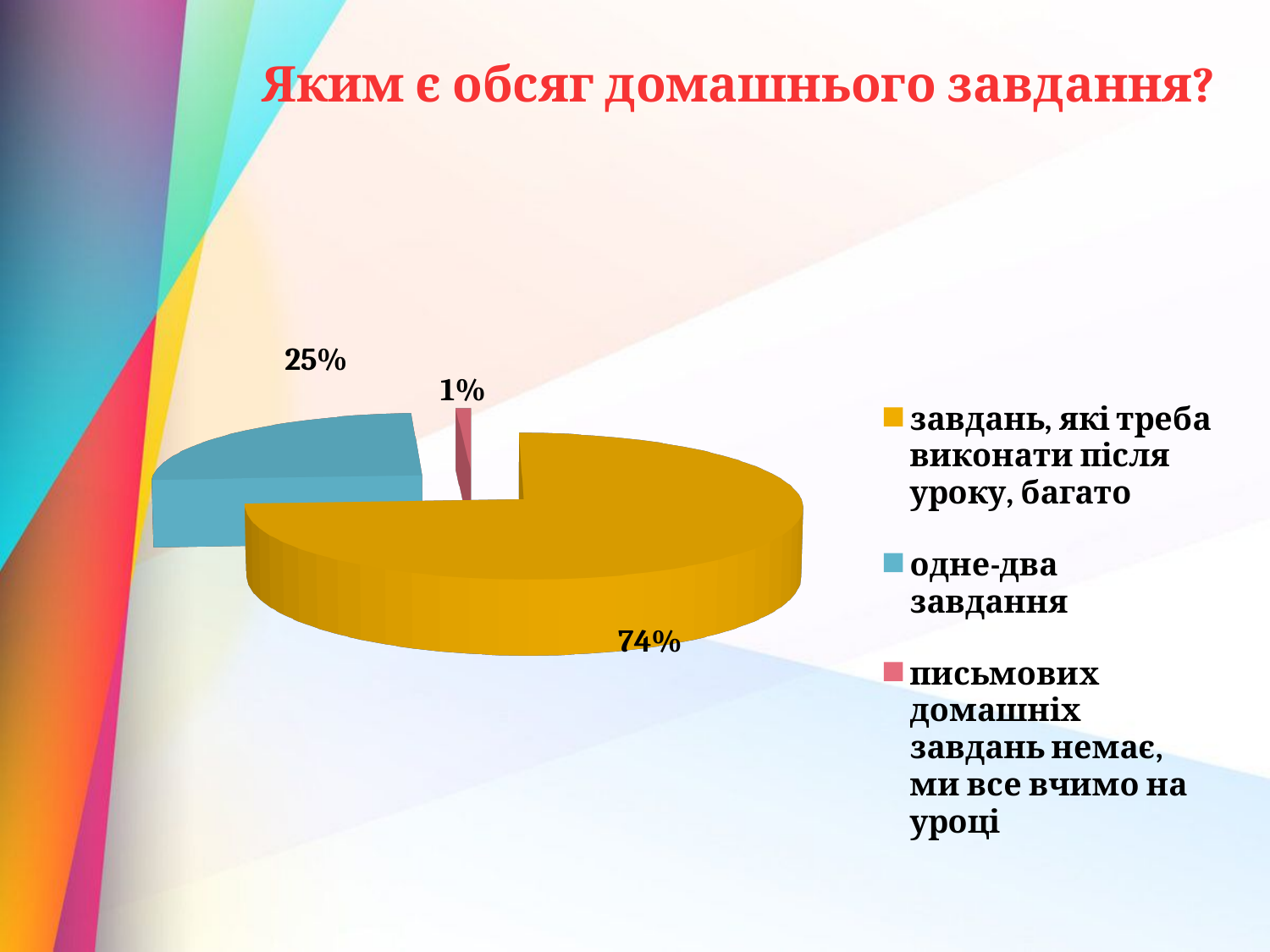
Which category has the largest slice of the pie? завдань, які треба виконати після уроку, багато How many categories does the pie chart show? 3 What share of the pie is labelled for 'одне-два завдання'? 25% What share of the pie is labelled for 'письмових домашніх завдань немає, ми все вчимо на уроці'? 1% Which category has the smallest slice of the pie? письмових домашніх завдань немає, ми все вчимо на уроці Which is larger: the 'одне-два завдання' slice or the 'письмових домашніх завдань немає, ми все вчимо на уроці' slice? одне-два завдання What is the difference in percentage points between the 'завдань, які треба виконати після уроку, багато' slice and the 'одне-два завдання' slice? 49 What share of the pie is labelled for 'завдань, які треба виконати після уроку, багато'? 74% What colour is the slice for 'одне-два завдання'? blue What kind of chart is shown on the slide? pie chart What is the title of the slide above the chart? Яким є обсяг домашнього завдання?